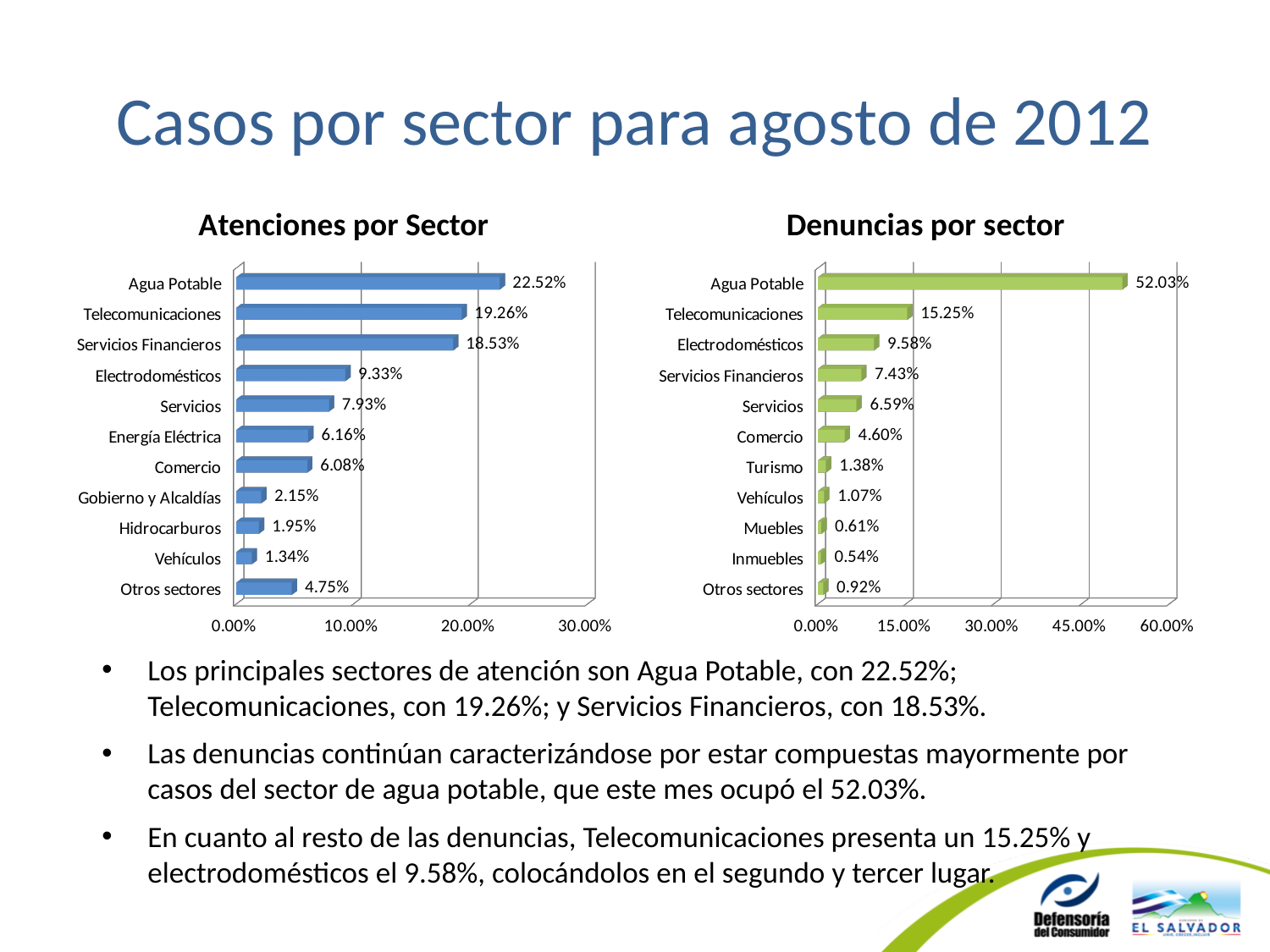
In the 'Denuncias por sector' chart, what is the value for Electrodomésticos? 9.58% In the 'Denuncias por sector' chart, which sector has the lowest value? Inmuebles What kind of chart is 'Atenciones por Sector'? Bar chart In the 'Atenciones por Sector' chart, what is the value for Servicios Financieros? 18.53% In the 'Atenciones por Sector' chart, what is the difference between Telecomunicaciones and Servicios Financieros? 0.73% How many sectors are shown in the 'Denuncias por sector' chart? 11 In the 'Denuncias por sector' chart, what is the difference between Agua Potable and Telecomunicaciones? 36.78% In the 'Denuncias por sector' chart, is the value for Agua Potable greater or less than 45.00%? greater In the 'Atenciones por Sector' chart, which sector has the highest value? Agua Potable In the 'Atenciones por Sector' chart, which is larger, Energía Eléctrica or Comercio? Energía Eléctrica What colour are the bars in the 'Denuncias por sector' chart? Green In the 'Atenciones por Sector' chart, which sector has the lowest value? Vehículos